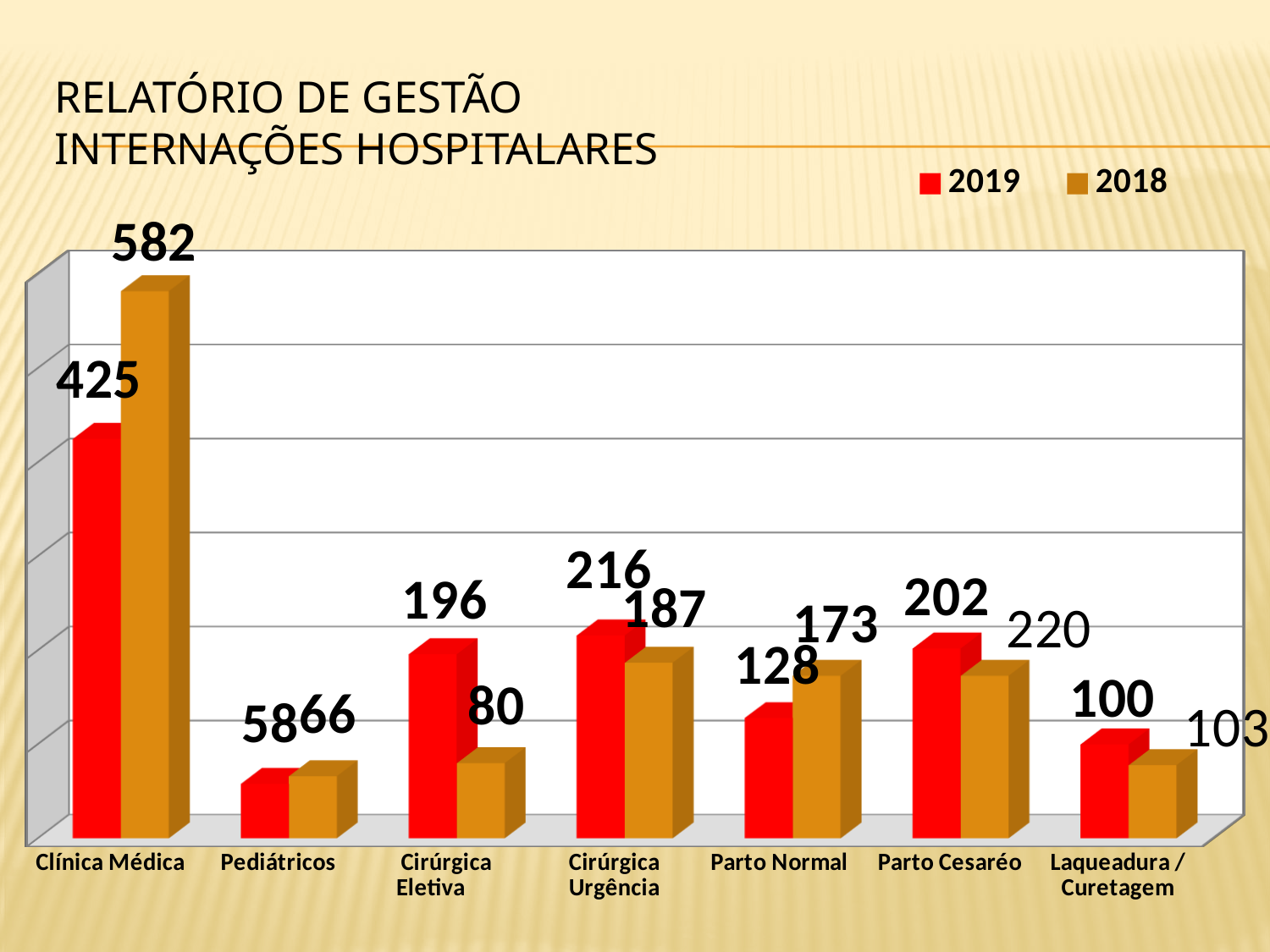
How many series does the legend list? 2 What is the 2019 value for Cirúrgica Eletiva? 196 How many categories are shown on the x axis? 7 Which category has the lowest 2019 value? Pediátricos What is the 2018 value for Clínica Médica? 582 Which category has the highest 2019 value? Clínica Médica For Cirúrgica Urgência, which year has the larger value, 2019 or 2018? 2019 What is the 2019 value for Clínica Médica? 425 What is the difference between the 2019 and 2018 values for Cirúrgica Eletiva? 116 What is the 2018 value for Parto Normal? 173 What is the difference between the 2018 and 2019 values for Clínica Médica? 157 What kind of chart is shown on the slide? Bar chart